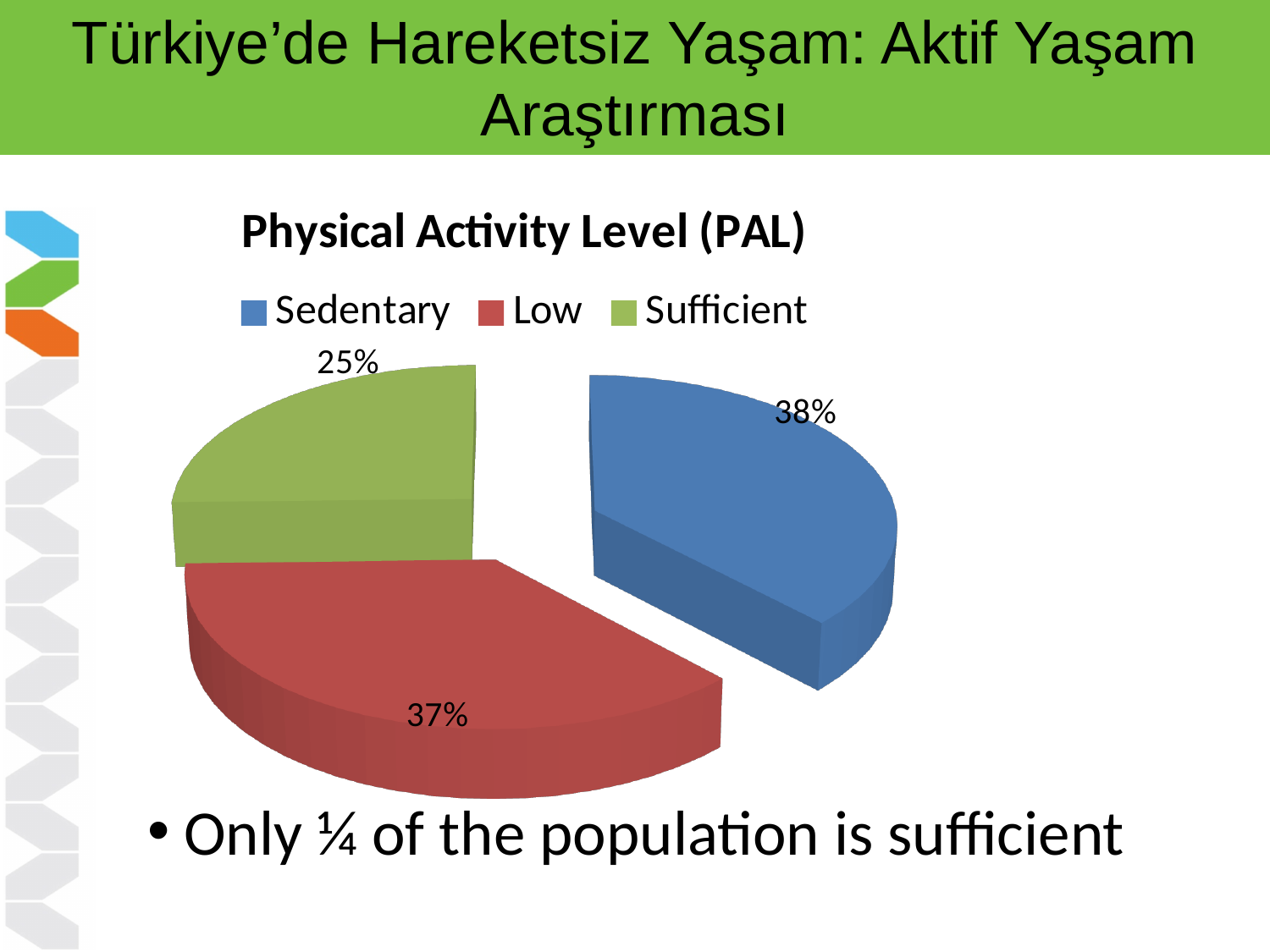
What is the difference in percentage points between the Low and Sufficient slices? 12 What percentage of the pie is labelled Sufficient? 25% How many slices does the pie chart have? 3 How many entries does the legend list? 3 Which category has the smallest share of the pie? Sufficient What is the difference in percentage points between the Sedentary and Sufficient slices? 13 What percentage of the pie is labelled Sedentary? 38% What percentage of the pie is labelled Low? 37% What kind of chart is shown on the slide? Pie chart What is the title of the chart? Physical Activity Level (PAL) Which category has the largest share of the pie? Sedentary Which slice is larger, Low or Sufficient? Low